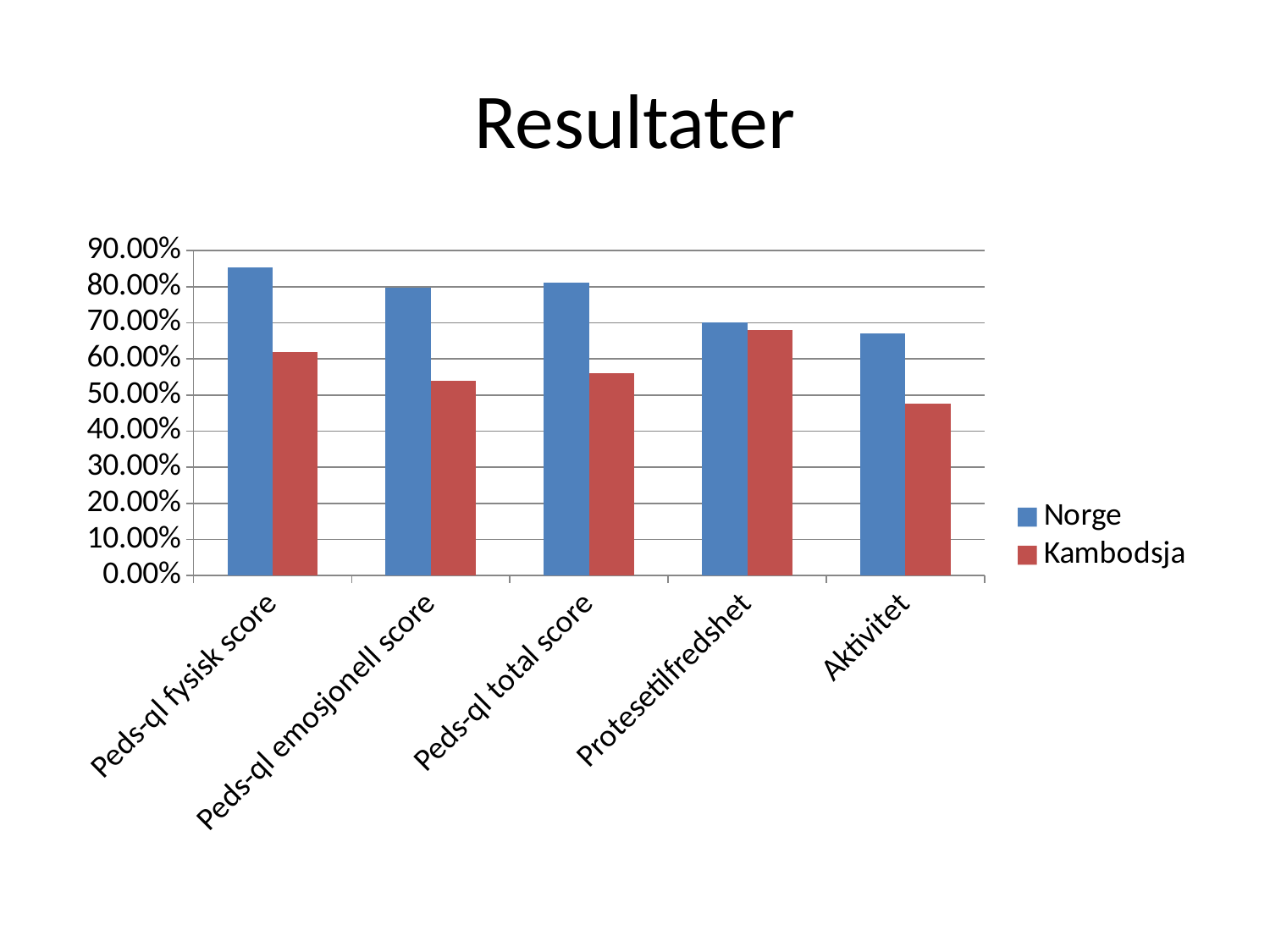
Is the Norge value for Aktivitet greater or less than 60.00%? greater Is the Norge value for Peds-ql fysisk score greater or less than 80.00%? greater What kind of chart is shown on the slide? bar chart Is the Kambodsja value for Peds-ql emosjonell score greater or less than 60.00%? less How many categories are shown on the x axis? 5 Which category has the lowest value for Kambodsja? Aktivitet What is the title of the slide? Resultater Which category has the highest value for Norge? Peds-ql fysisk score How many series does the legend list? 2 Which category has the highest value for Kambodsja? Protesetilfredshet For Peds-ql fysisk score, which series has the larger value, Norge or Kambodsja? Norge